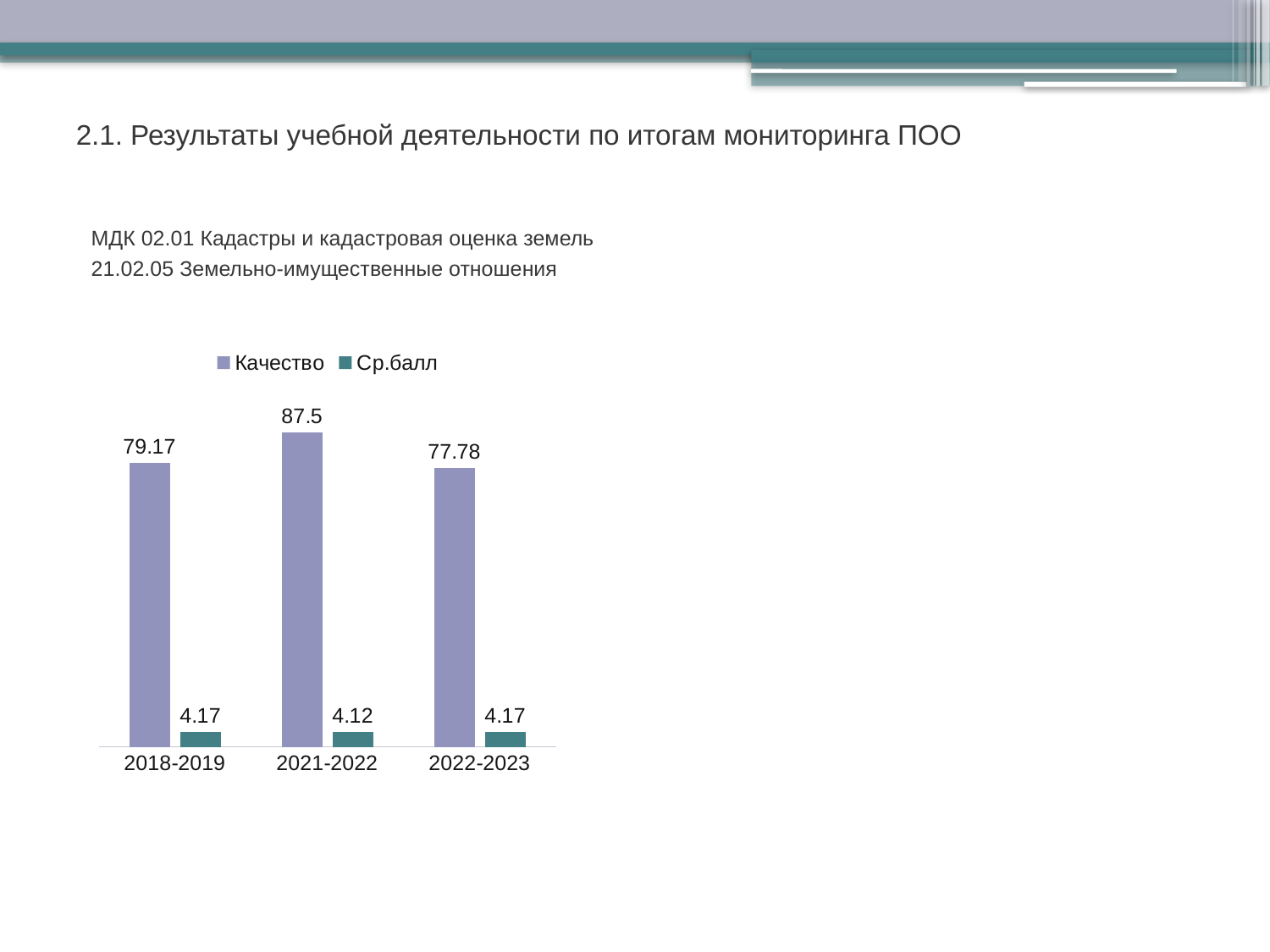
What are the two series named in the chart legend? Качество and Ср.балл What type of chart is shown on the slide? bar chart Which period has the lowest Качество value? 2022-2023 What is the value of Ср.балл for 2021-2022? 4.12 How many series does the legend list? 2 Which is larger, the Качество value for 2018-2019 or for 2022-2023? 2018-2019 How many periods are shown on the x axis of the chart? 3 What is the value of Ср.балл for 2018-2019? 4.17 What is the difference between the Качество values for 2021-2022 and 2018-2019? 8.33 What is the value of Качество for 2021-2022? 87.5 What is the value of Качество for 2022-2023? 77.78 Which period has the highest Качество value? 2021-2022